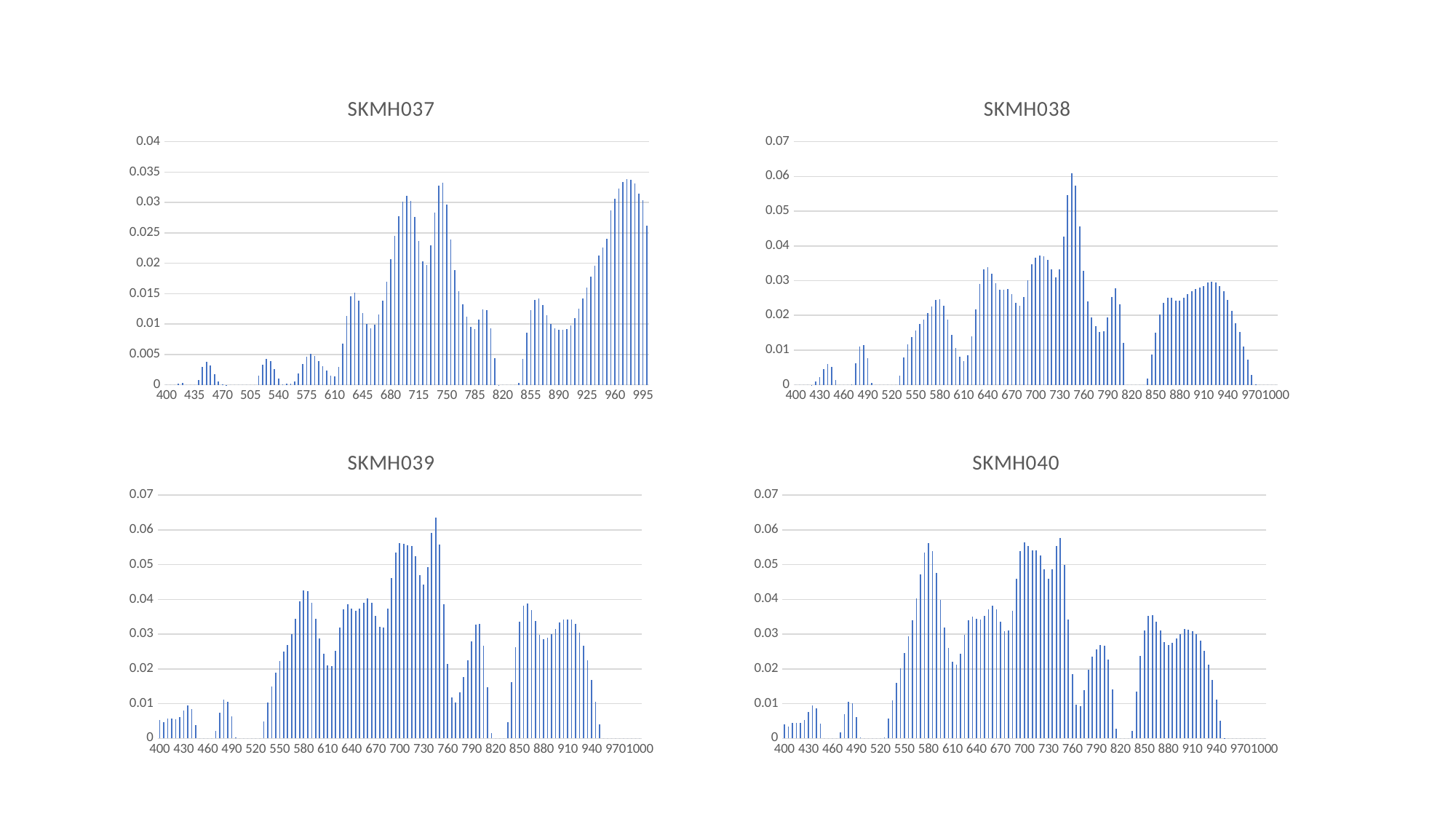
In the SKMH040 chart, is the tallest bar (near 750 on the x axis) greater or less than 0.04? greater In the SKMH037 chart, do the values rise or fall along the x axis from 890 to 975? rise In the SKMH038 chart, which is larger: the peak near 745 or the peak near 640 on the x axis? the peak near 745 In the SKMH039 chart, is the tallest bar (near 750 on the x axis) greater or less than 0.05? greater In the SKMH037 chart, is the tallest bar (near 975 on the x axis) greater or less than 0.03? greater What is the title of the chart in the bottom-right position of the slide? SKMH040 How many charts are shown on the slide? 4 What kind of chart is SKMH037? bar chart In the SKMH037 chart, what is the highest value labelled on the vertical axis? 0.04 In the SKMH039 chart, which is larger: the peak near 750 or the peak near 580 on the x axis? the peak near 750